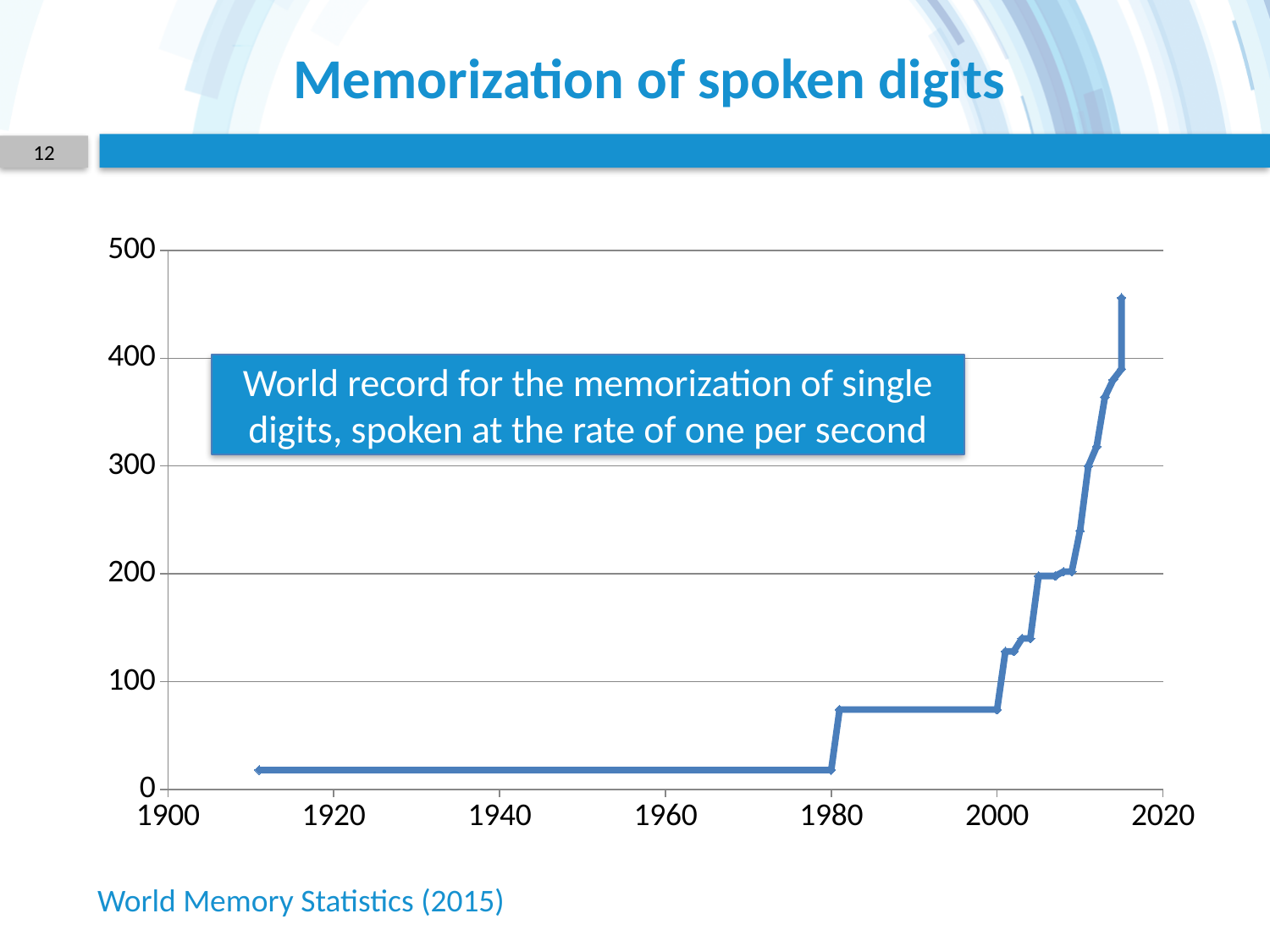
Does the highest value on the chart occur at the beginning or at the end of the time period? end Is the value of the last plotted point (around 2015) greater or less than 400? greater What kind of chart is shown on the slide? line chart Do the values on the chart generally rise or fall as the years increase along the x axis? rise Is the value plotted around 1980 greater or less than 100? less Is the value plotted around 1920 greater or less than 100? less What is the title of the slide containing the chart? Memorization of spoken digits How many lines (data series) are plotted on the chart? 1 What is the highest value shown on the chart's vertical axis? 500